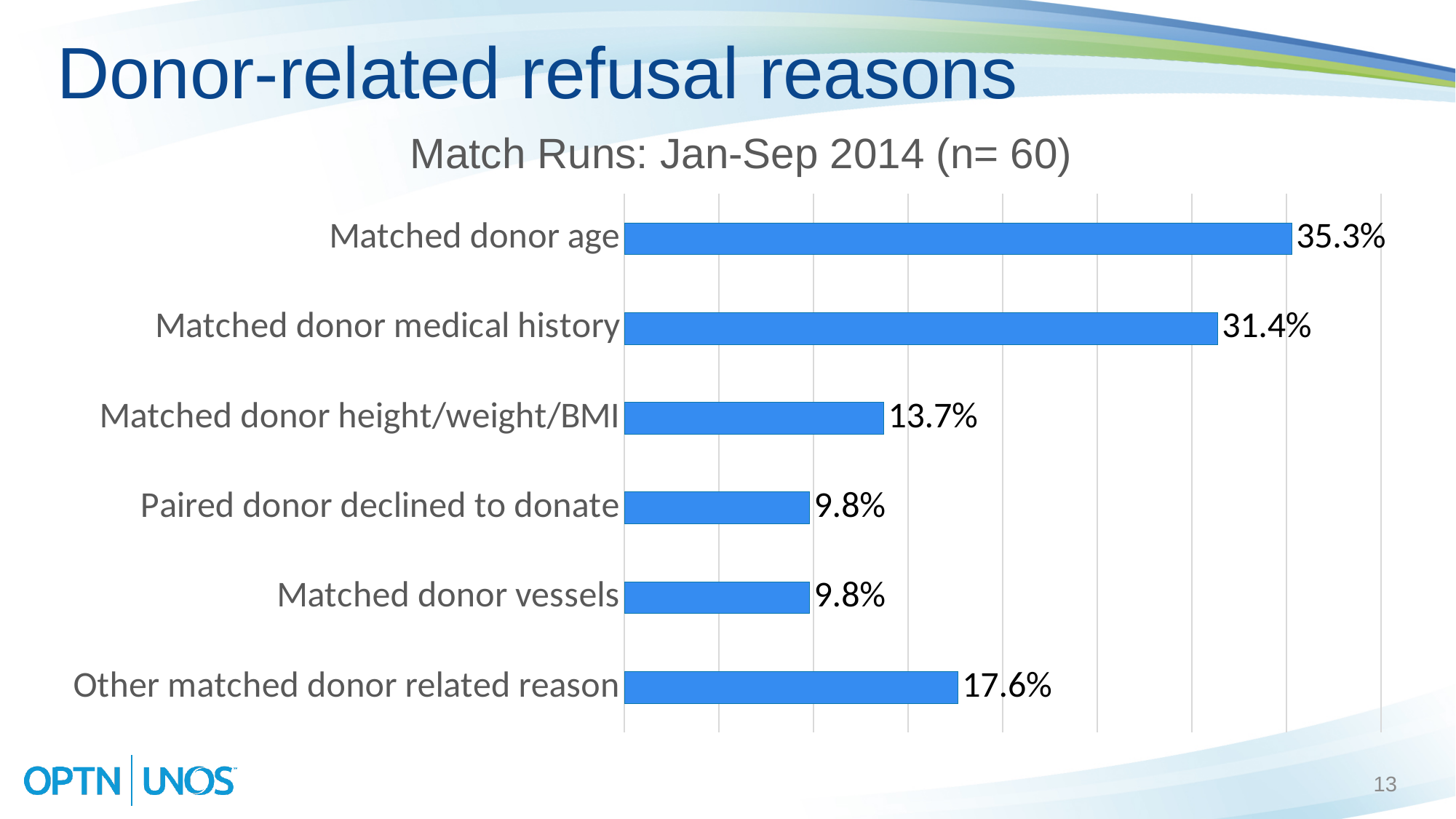
What is the chart's title? Match Runs: Jan-Sep 2014 (n= 60) How many categories are shown in the chart? 6 What is the value for Matched donor age? 35.3% What is the value for Other matched donor related reason? 17.6% What kind of chart is shown on the slide? Bar chart Which is larger, Matched donor height/weight/BMI or Other matched donor related reason? Other matched donor related reason What is the difference between Matched donor age and Matched donor medical history? 3.9% What is the difference between Other matched donor related reason and Matched donor height/weight/BMI? 3.9% What is the value for Matched donor height/weight/BMI? 13.7% Which category has the highest value? Matched donor age What is the value for Matched donor vessels? 9.8% What is the value for Matched donor medical history? 31.4%